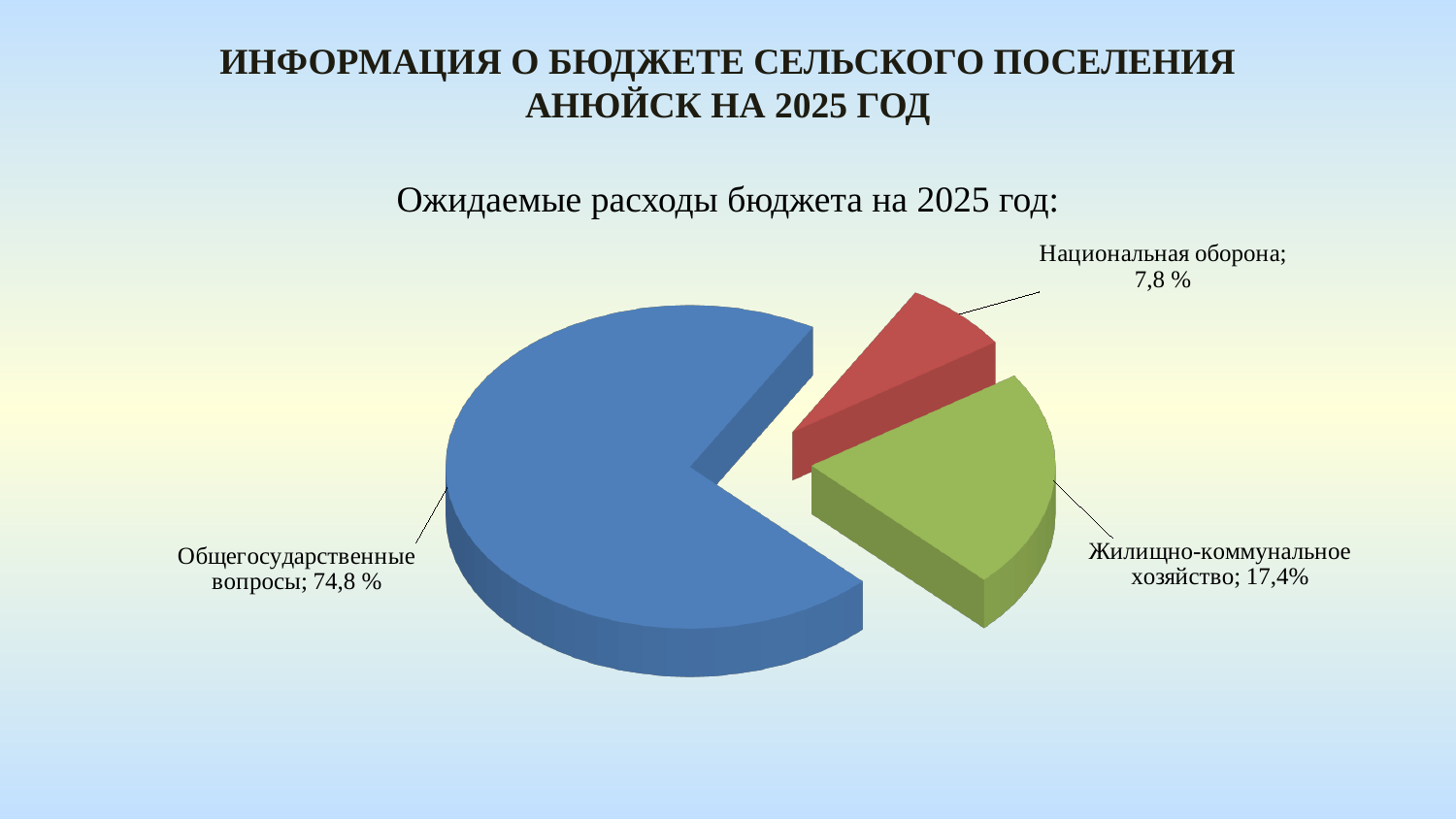
By how many percentage points does the share for Общегосударственные вопросы exceed the share for Жилищно-коммунальное хозяйство? 57,4 % What is the subtitle printed above the pie chart? Ожидаемые расходы бюджета на 2025 год: Which category has the smallest share of the expected 2025 budget expenditures? Национальная оборона By how many percentage points does the share for Жилищно-коммунальное хозяйство exceed the share for Национальная оборона? 9,6 % What colour is the slice for Национальная оборона? Red What kind of chart is shown on the slide? Pie chart What share of expected 2025 budget expenditures goes to Жилищно-коммунальное хозяйство? 17,4% Which is larger: the share for Жилищно-коммунальное хозяйство or the share for Национальная оборона? Жилищно-коммунальное хозяйство How many categories are shown in the pie chart? 3 Which category has the largest share of the expected 2025 budget expenditures? Общегосударственные вопросы What share of expected 2025 budget expenditures goes to Национальная оборона? 7,8 % What share of expected 2025 budget expenditures goes to Общегосударственные вопросы? 74,8 %